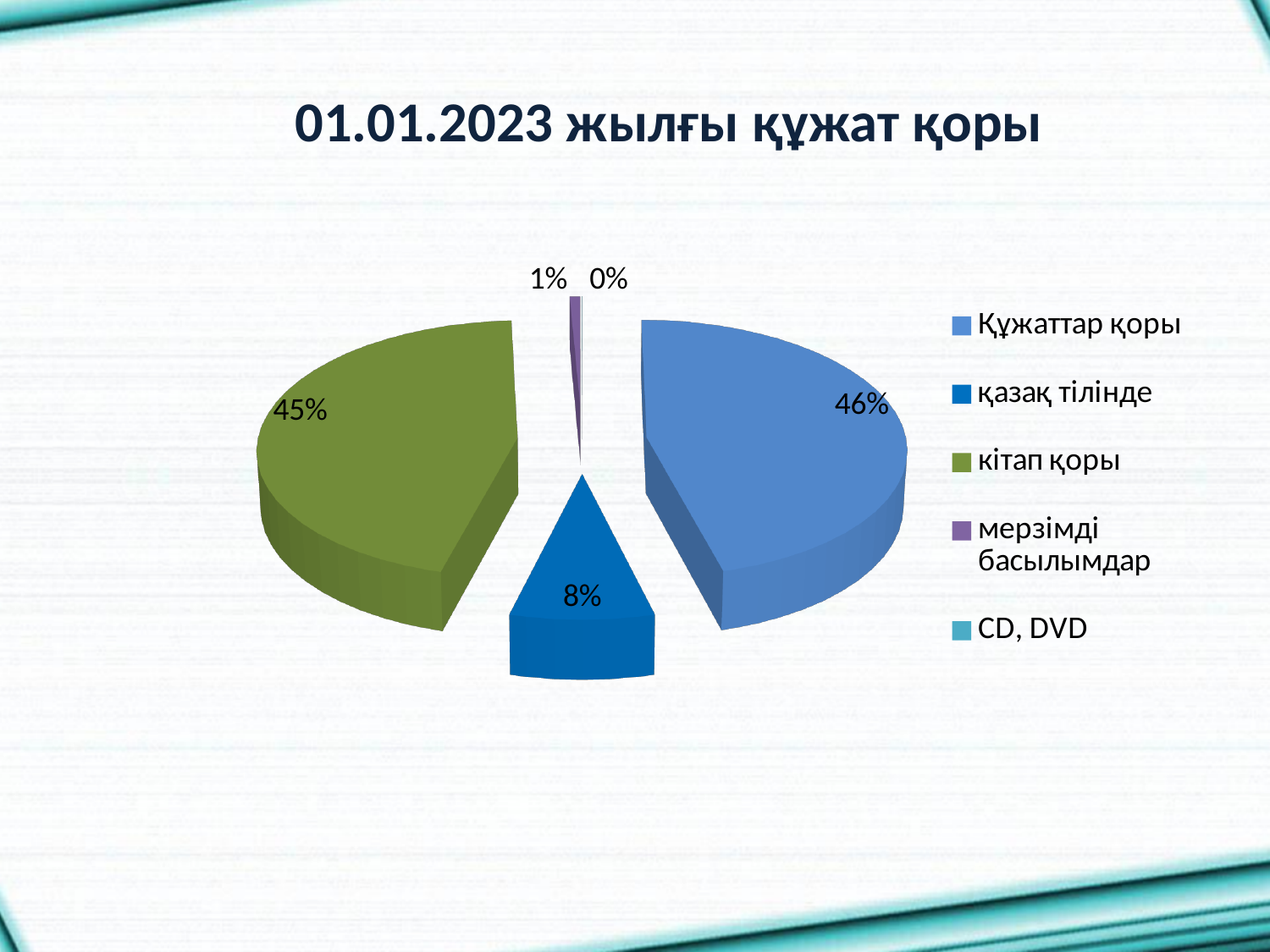
What is the title of the chart? 01.01.2023 жылғы құжат қоры Which category has the smallest share of the pie? CD, DVD What share of the pie is CD, DVD? 0% What share of the pie is мерзімді басылымдар? 1% What share of the pie is кітап қоры? 45% What colour is the slice for кітап қоры? green What is the difference in percentage points between Құжаттар қоры and қазақ тілінде? 38 How many categories does the legend list? 5 What kind of chart is shown on the slide? pie chart Which is larger, the share for кітап қоры or the share for қазақ тілінде? кітап қоры